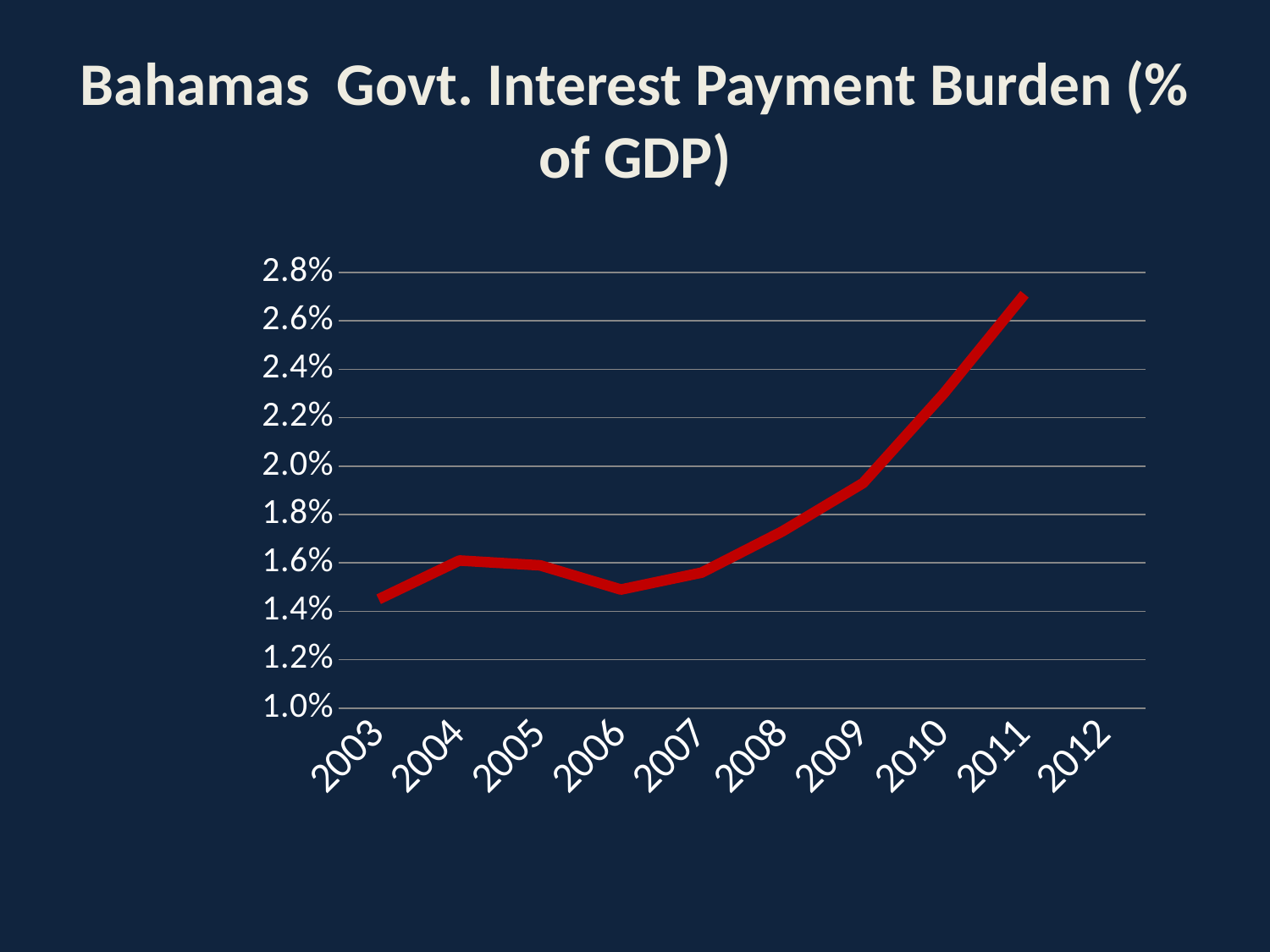
Does the interest payment burden rise or fall from 2007 to 2011? rise Is the value for 2008 greater or less than 1.8%? less Is the value for 2003 greater or less than 1.6%? less How many years are labeled on the x axis? 10 Is the value for 2011 greater or less than 2.4%? greater Which year has the larger value, 2004 or 2006? 2004 What colour is the plotted line? red What is the title of the chart? Bahamas Govt. Interest Payment Burden (% of GDP) Which year has the larger value, 2003 or 2011? 2011 Which year has the highest interest payment burden? 2011 What kind of chart is shown on the slide? line chart